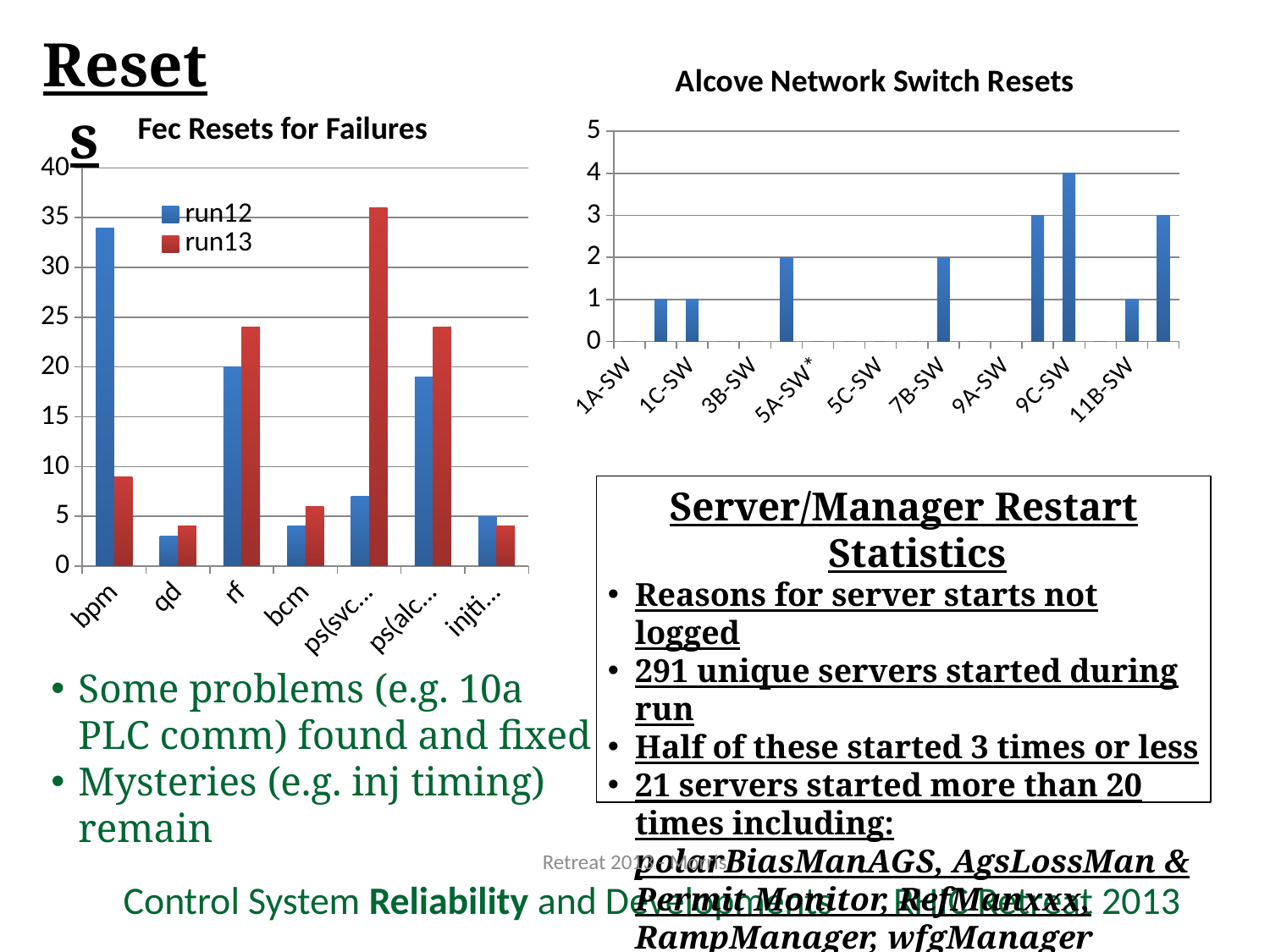
In the 'Fec Resets for Failures' chart, which is larger for rf, run12 or run13? run13 What kind of chart is the 'Fec Resets for Failures' chart? bar chart What are the two series named in the legend of the 'Fec Resets for Failures' chart? run12 and run13 How many series does the legend of the 'Fec Resets for Failures' chart list? 2 In the 'Fec Resets for Failures' chart, is the run13 value for ps(svc... greater or less than 30? greater What kind of chart is the 'Alcove Network Switch Resets' chart? bar chart In the 'Alcove Network Switch Resets' chart, what is the highest value reached by any bar? 4 In the 'Fec Resets for Failures' chart, which is larger for bpm, run12 or run13? run12 In the 'Fec Resets for Failures' chart, which category has the highest run13 value? ps(svc... In the 'Fec Resets for Failures' chart, which category has the highest run12 value? bpm In the 'Fec Resets for Failures' chart, is the run13 value for bpm greater or less than 15? less In the 'Fec Resets for Failures' chart, is the run12 value for bpm greater or less than 30? greater